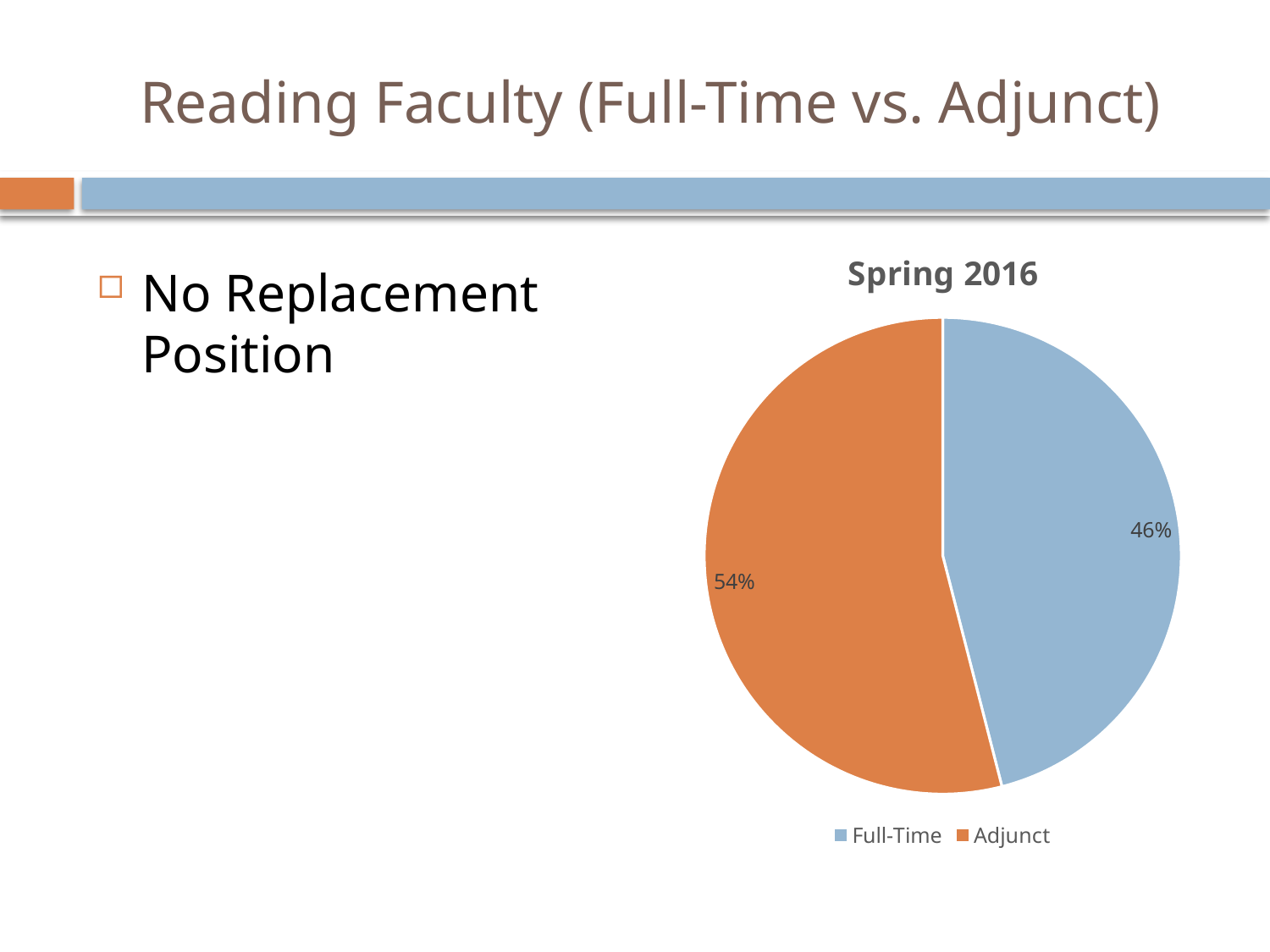
What percentage of the pie is Full-Time? 46% What kind of chart is shown on the slide? pie chart Which colour represents Adjunct in the pie chart? orange Is the Full-Time share greater or less than 50%? less How many slices does the pie chart have? 2 Which category has the largest share of the pie? Adjunct What is the difference in percentage points between the Adjunct share and the Full-Time share? 8 What is the title of the chart? Spring 2016 What percentage of the pie is Adjunct? 54% Which category has the smallest share of the pie? Full-Time Which is larger, the Full-Time share or the Adjunct share? Adjunct How many entries does the legend list? 2